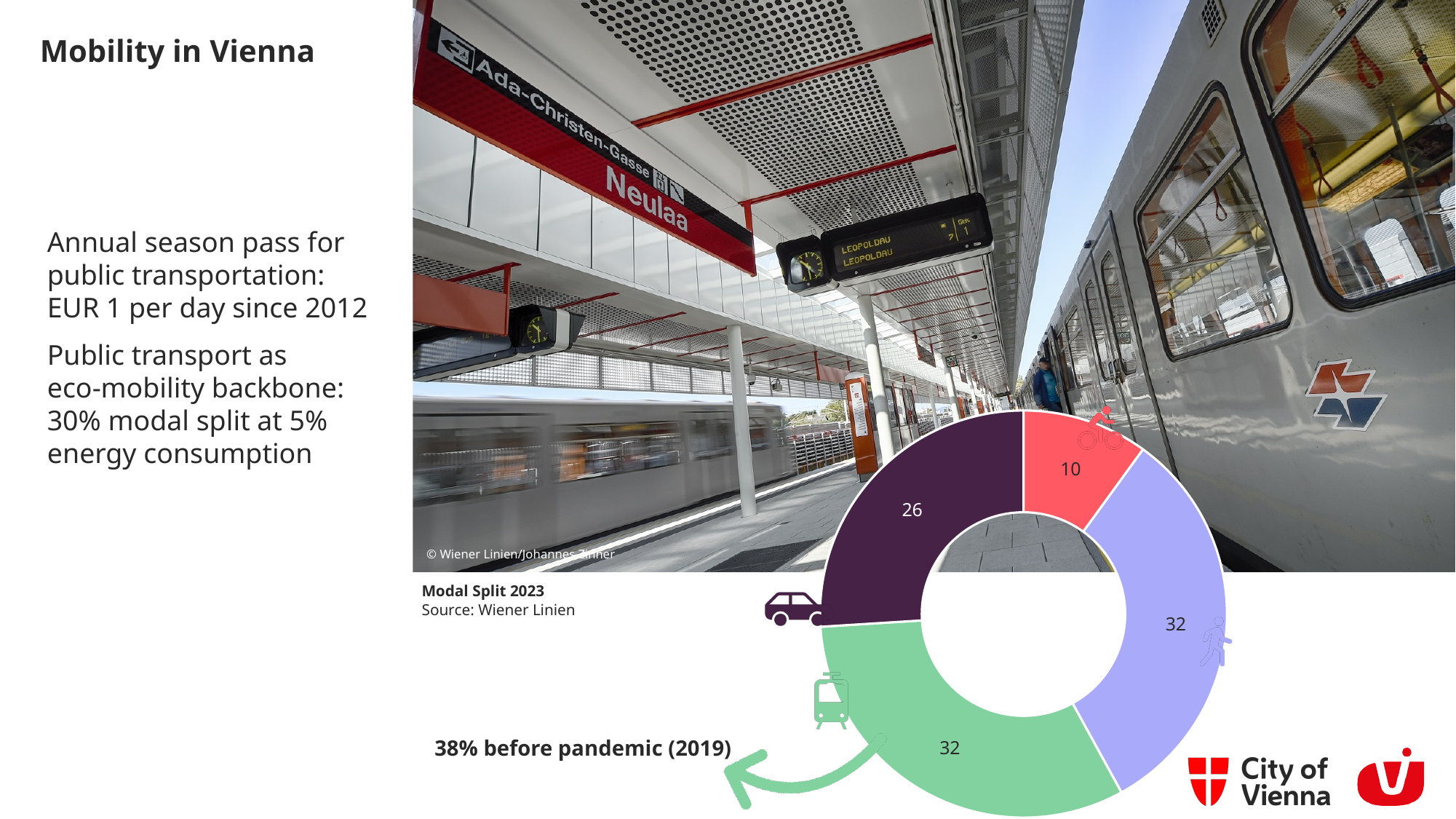
What share of the Modal Split 2023 chart does the car segment represent? 26% What is the title of the chart on the slide? Modal Split 2023 What is the total of all segment values in the Modal Split 2023 chart? 100 What is the value of the red segment marked with the bicycle icon in the Modal Split 2023 chart? 10 According to the annotation on the slide, what was the public transport share before the pandemic (2019)? 38% Which is larger in the Modal Split 2023 chart: the car segment or the bicycle segment? The car segment (26) What is the difference between the car segment (26) and the bicycle segment (10) in the Modal Split 2023 chart? 16 How many segments does the Modal Split 2023 chart have? 4 What kind of chart is shown on the slide? Donut (pie) chart What is the value of the dark purple segment marked with the car icon in the Modal Split 2023 chart? 26 What is the value of the green segment marked with the tram icon in the Modal Split 2023 chart? 32 Which segment of the Modal Split 2023 chart has the smallest value? The red segment with the bicycle icon (10)